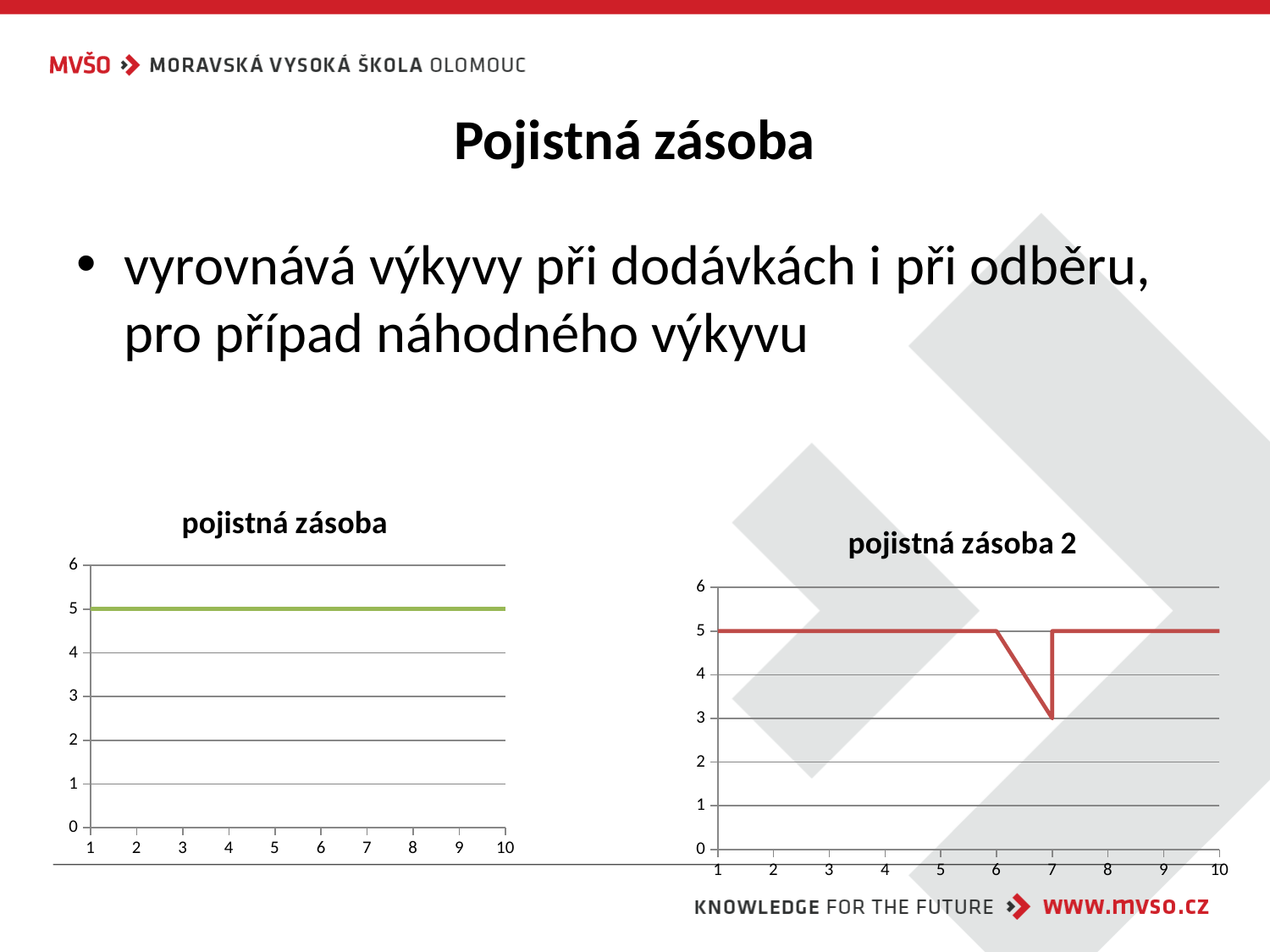
In the chart titled "pojistná zásoba", what is the value at x = 4? 5 In the chart titled "pojistná zásoba 2", which is larger: the value at x = 2 or the lowest value at x = 7? the value at x = 2 In the chart titled "pojistná zásoba 2", what is the lowest value the line reaches? 3 In the chart titled "pojistná zásoba", do the values rise, fall or stay flat along the x axis? stay flat What type of chart is the chart titled "pojistná zásoba" on the left? line chart In the chart titled "pojistná zásoba 2", what is the difference between the value at x = 5 and the lowest value at x = 7? 2 In the chart titled "pojistná zásoba 2", what is the value at x = 3? 5 In the chart titled "pojistná zásoba", how many points are plotted along the x axis? 10 What type of chart is the chart titled "pojistná zásoba 2" on the right? line chart What is the maximum value shown on the y axis of the chart titled "pojistná zásoba"? 6 In the chart titled "pojistná zásoba 2", is the value at x = 9 greater or less than 4? greater In the chart titled "pojistná zásoba 2", at which x value does the line reach its lowest point? 7